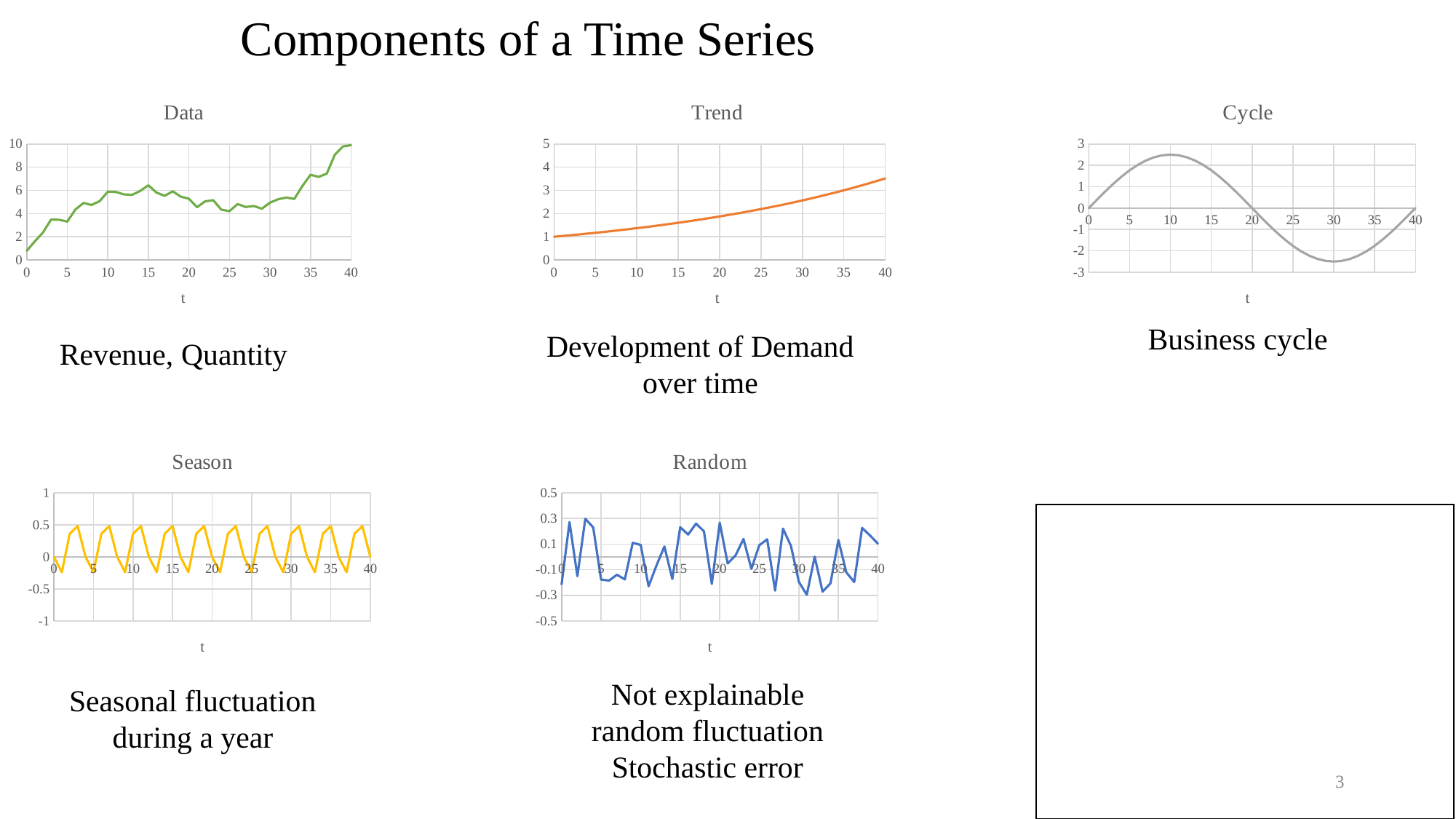
In the 'Data' chart, is the value at t = 40 greater or less than 8? greater In the 'Trend' chart, do the values rise or fall as t increases? rise In the 'Data' chart, which is larger: the value at t = 0 or the value at t = 40? t = 40 What is the x-axis label on the 'Season' chart? t In the 'Cycle' chart, is the value at t = 10 greater or less than 2? greater In the 'Season' chart, is the highest value reached greater or less than 1? less What is the title of the chart at the top right of the slide? Cycle What kind of chart is the 'Data' chart? line chart